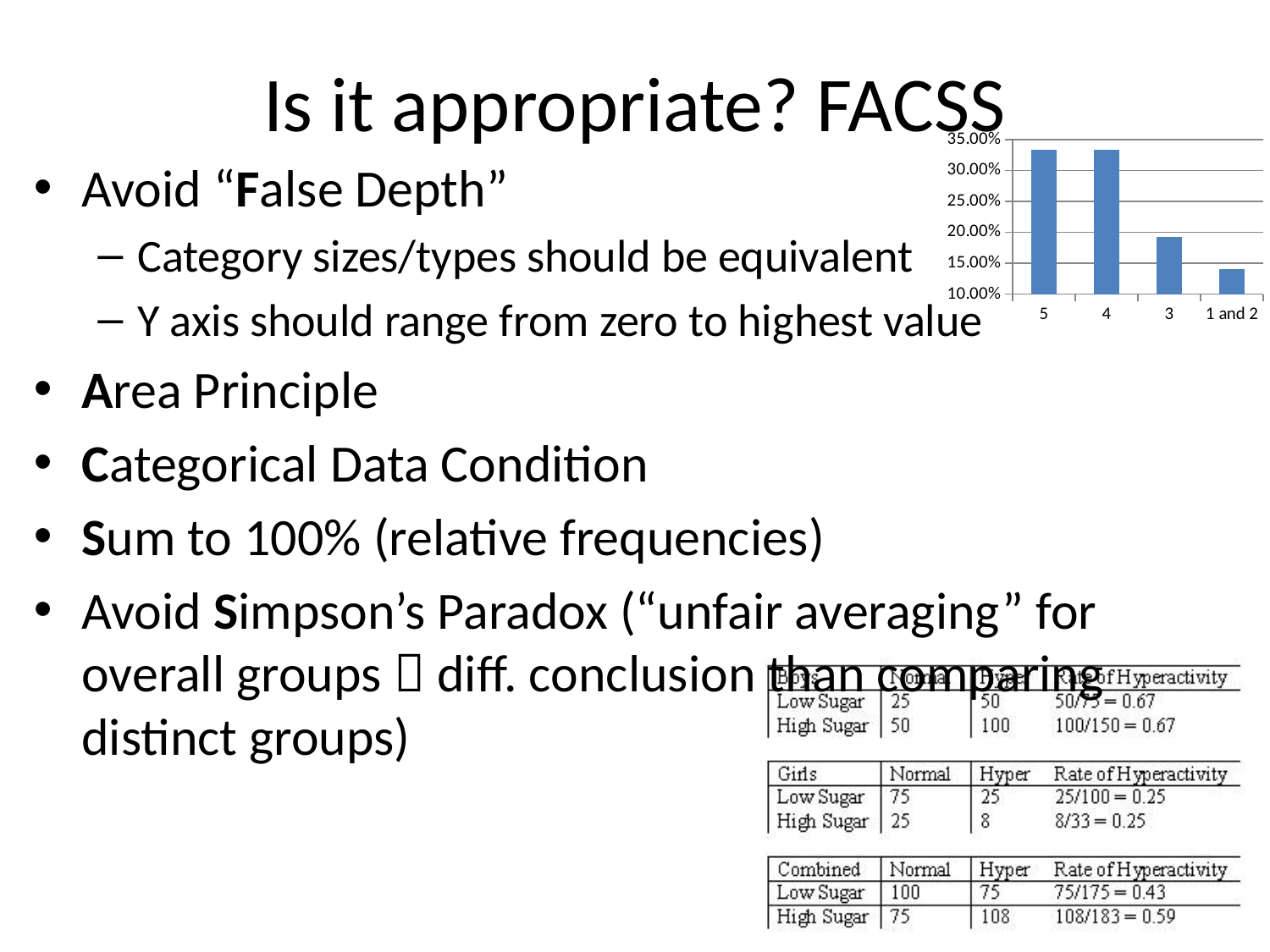
Do the values in the bar chart rise or fall moving from left to right along the x axis? fall In the bar chart, which is larger: the value for category 3 or the value for category '1 and 2'? 3 In the bar chart, which is larger: the value for category 5 or the value for category 3? 5 How many categories are shown on the x axis of the bar chart? 4 Is the value for category 4 in the bar chart greater or less than 30.00%? greater Is the value for category 5 in the bar chart greater or less than 30.00%? greater Which category has the lowest value in the bar chart? 1 and 2 What is the lowest value shown on the y axis of the bar chart? 10.00% Is the value for category 3 in the bar chart greater or less than 25.00%? less What kind of chart is shown in the top right of the slide? bar chart What is the highest value shown on the y axis of the bar chart? 35.00%